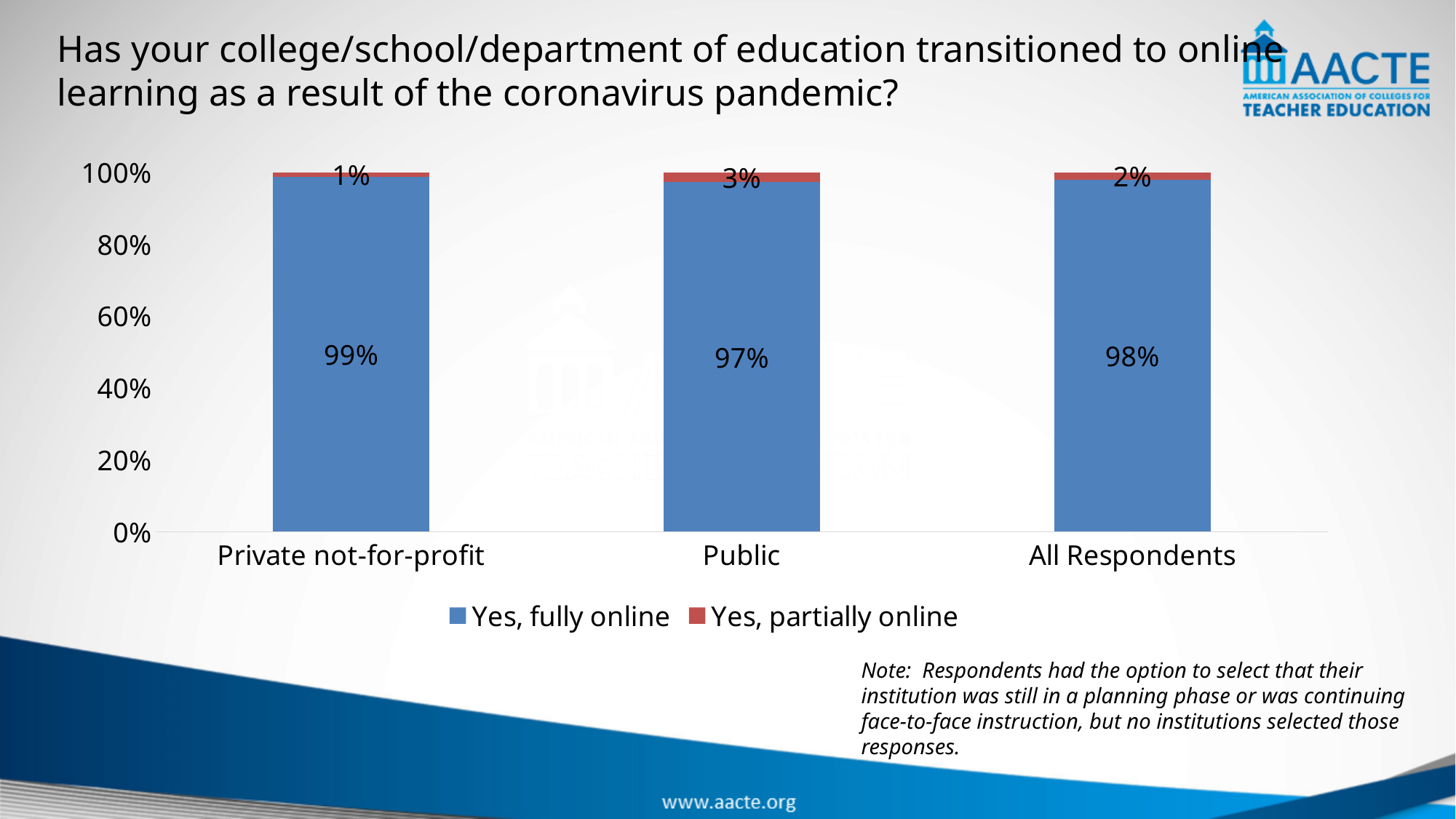
Which category has the lowest "Yes, partially online" percentage? Private not-for-profit Which category has the highest "Yes, fully online" percentage? Private not-for-profit How many categories are shown on the x axis? 3 What is the "Yes, partially online" value for Private not-for-profit? 1% What is the "Yes, fully online" value for All Respondents? 98% How many series does the legend list? 2 What percentage of Private not-for-profit respondents answered "Yes, fully online"? 99% Which is larger: the "Yes, partially online" value for Public or for All Respondents? Public What kind of chart is shown on the slide? Stacked bar chart What is the difference between the "Yes, fully online" values for Private not-for-profit and Public? 2% What is the total of the stacked bar for Public? 100% What percentage of Public respondents answered "Yes, partially online"? 3%